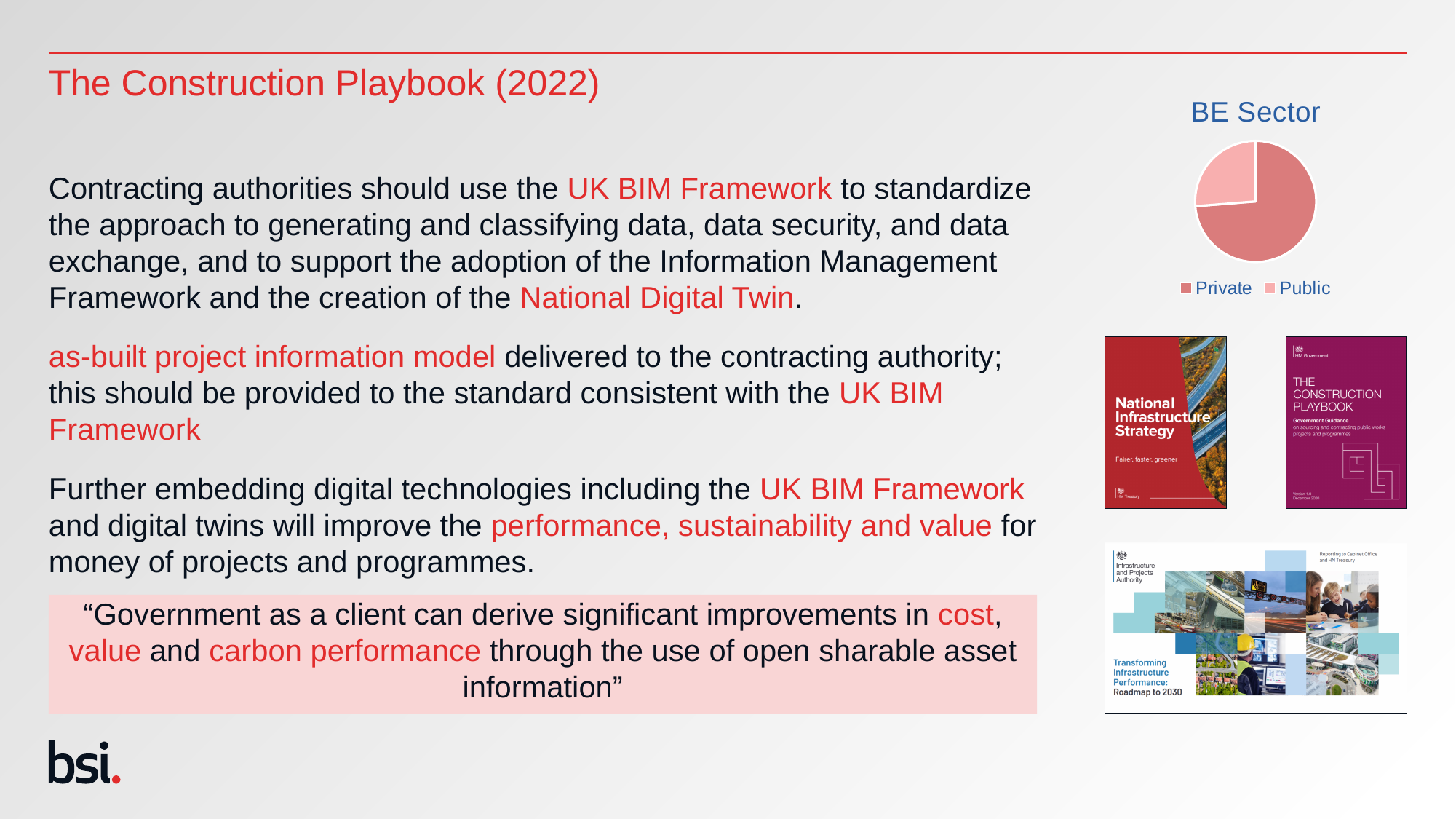
What are the two categories listed in the legend of the "BE Sector" pie chart? Private and Public In the "BE Sector" pie chart, which slice is larger, Private or Public? Private What kind of chart is shown under the title "BE Sector"? pie chart Which category has the smallest slice in the "BE Sector" pie chart? Public What is the title of the pie chart on the slide? BE Sector Which category has the largest slice in the "BE Sector" pie chart? Private How many entries does the legend of the "BE Sector" pie chart list? 2 How many slices does the "BE Sector" pie chart have? 2